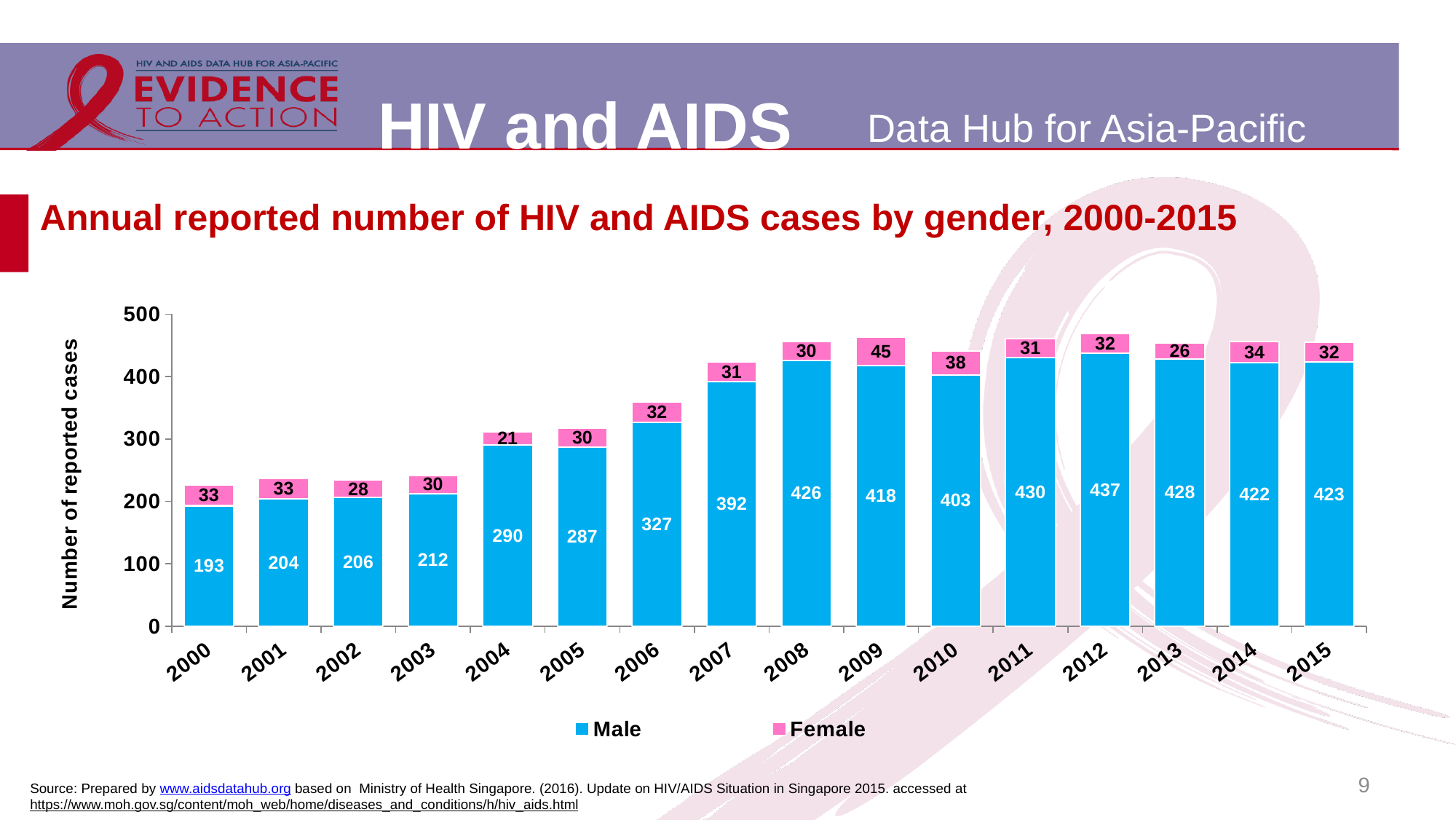
Which year has the highest number of reported Male cases? 2012 What is the total number of reported cases (Male plus Female) in 2012? 469 Do the Male cases rise or fall from 2000 to 2008? Rise Which year has the lowest number of reported Female cases? 2004 Which is larger, the Male cases in 2008 or the Male cases in 2009? 2008 How many years are shown on the x axis? 16 What is the number of reported Male cases in 2007? 392 What is the difference between the Male cases in 2012 and the Male cases in 2000? 244 What kind of chart is shown on the slide? Stacked bar chart How many series does the legend list? 2 What is the number of reported Female cases in 2009? 45 Which colour represents the Female series? Pink